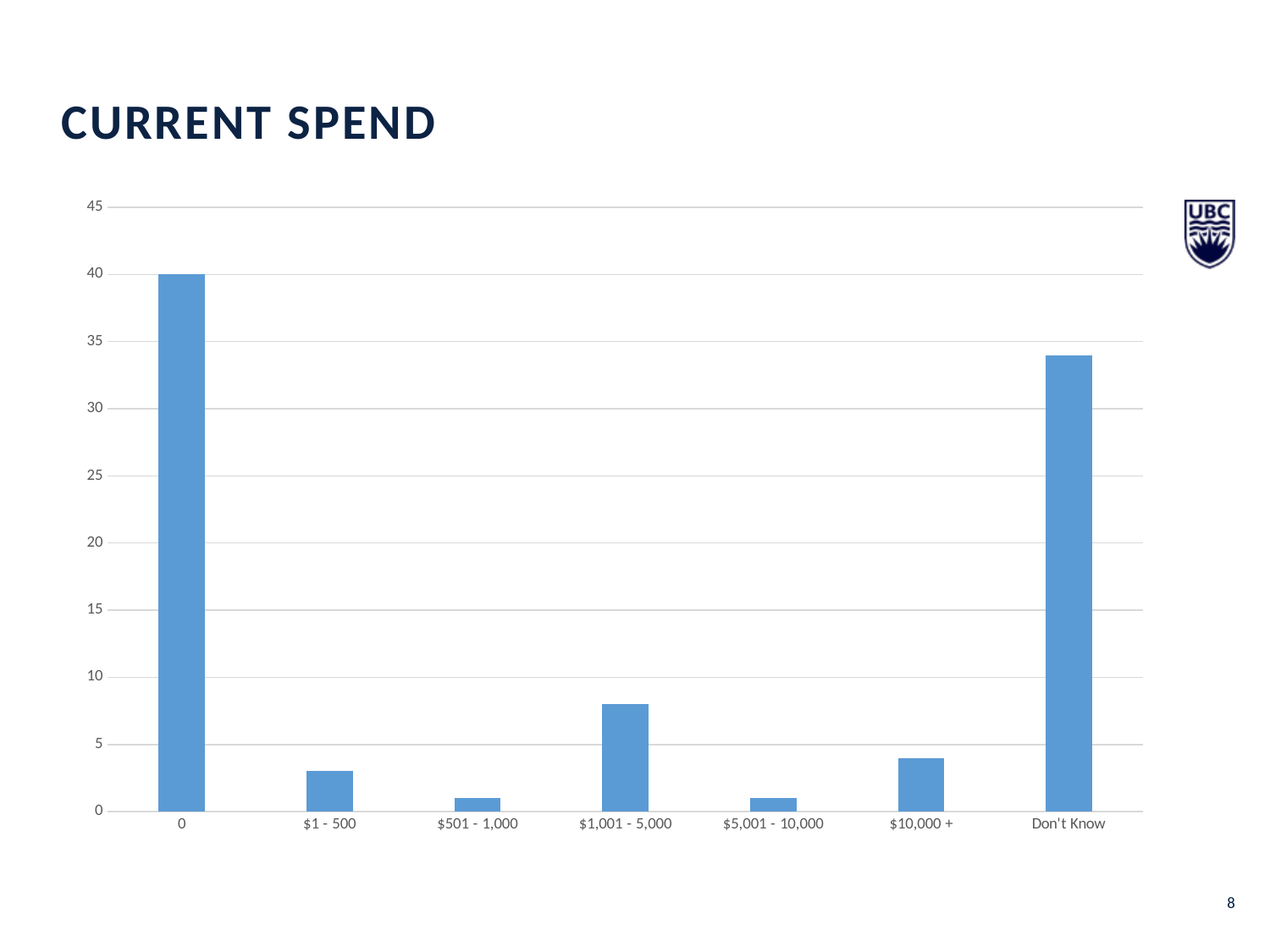
Is the value for "$1 - 500" greater or less than 5? less Is the value for "$10,000 +" greater or less than 5? less What is the value for the "0" category? 40 How many categories are shown on the x axis? 7 Is the value for "Don't Know" greater or less than 30? greater What kind of chart is shown on the slide? Bar chart What is the title of the slide containing the chart? CURRENT SPEND Which is larger, the value for "0" or the value for "Don't Know"? 0 Which is larger, the value for "Don't Know" or the value for "$1,001 - 5,000"? Don't Know Which category has the highest value? 0